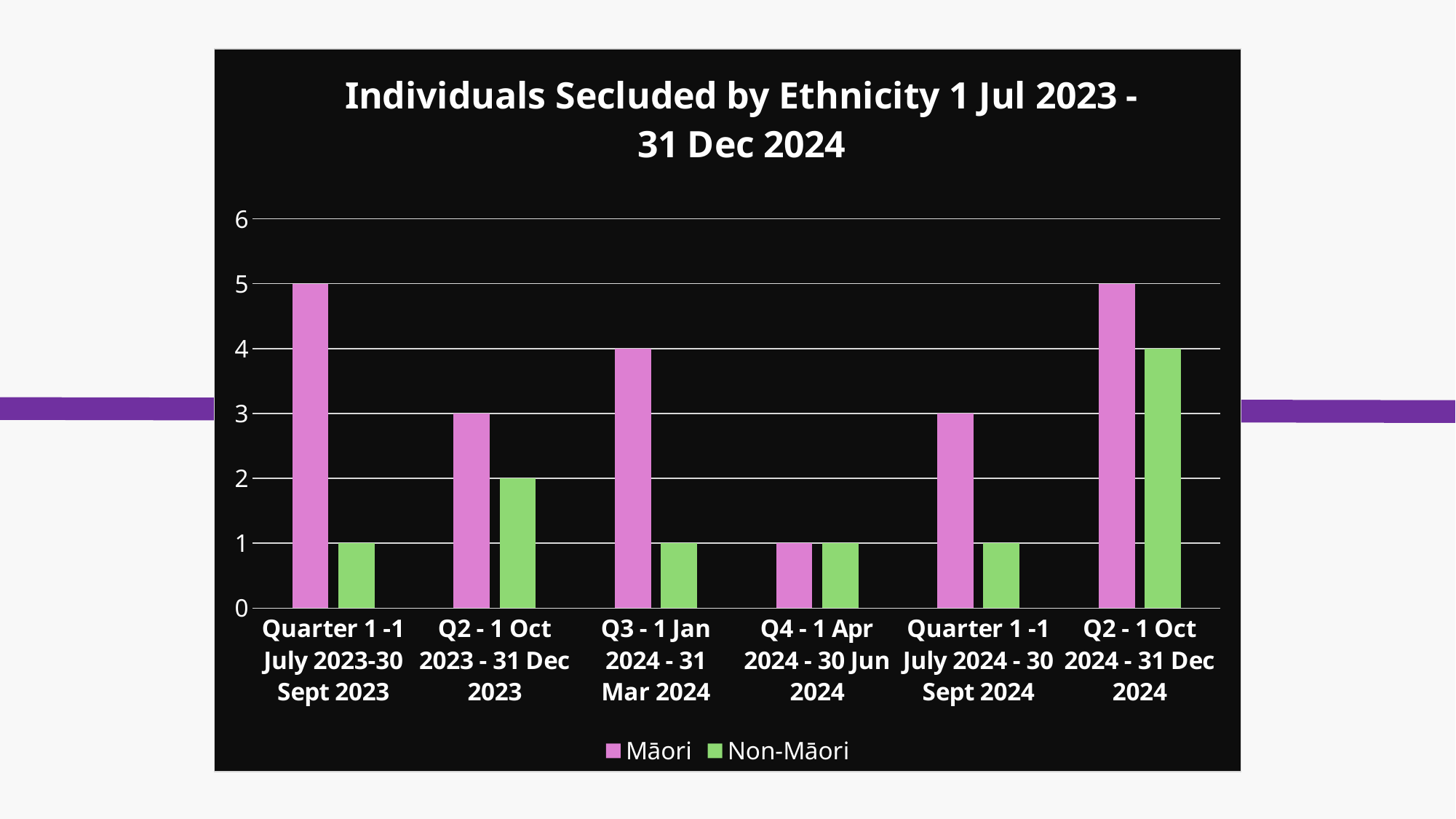
Is the Māori value larger than the Non-Māori value for Quarter 1 - 1 July 2024 - 30 Sept 2024? Yes What is the Non-Māori value for Q2 - 1 Oct 2023 - 31 Dec 2023? 2 Which quarter has the lowest Māori value? Q4 - 1 Apr 2024 - 30 Jun 2024 What is the difference between the Māori and Non-Māori values for Quarter 1 - 1 July 2023-30 Sept 2023? 4 Which quarter has the highest Non-Māori value? Q2 - 1 Oct 2024 - 31 Dec 2024 How many series does the legend list? 2 What is the title of the chart? Individuals Secluded by Ethnicity 1 Jul 2023 - 31 Dec 2024 How many quarters are shown on the x axis? 6 Is the Māori value for Q2 - 1 Oct 2024 - 31 Dec 2024 greater or less than 4? greater What is the Non-Māori value for Q2 - 1 Oct 2024 - 31 Dec 2024? 4 What is the Māori value for Q3 - 1 Jan 2024 - 31 Mar 2024? 4 What kind of chart is shown on the slide? bar chart